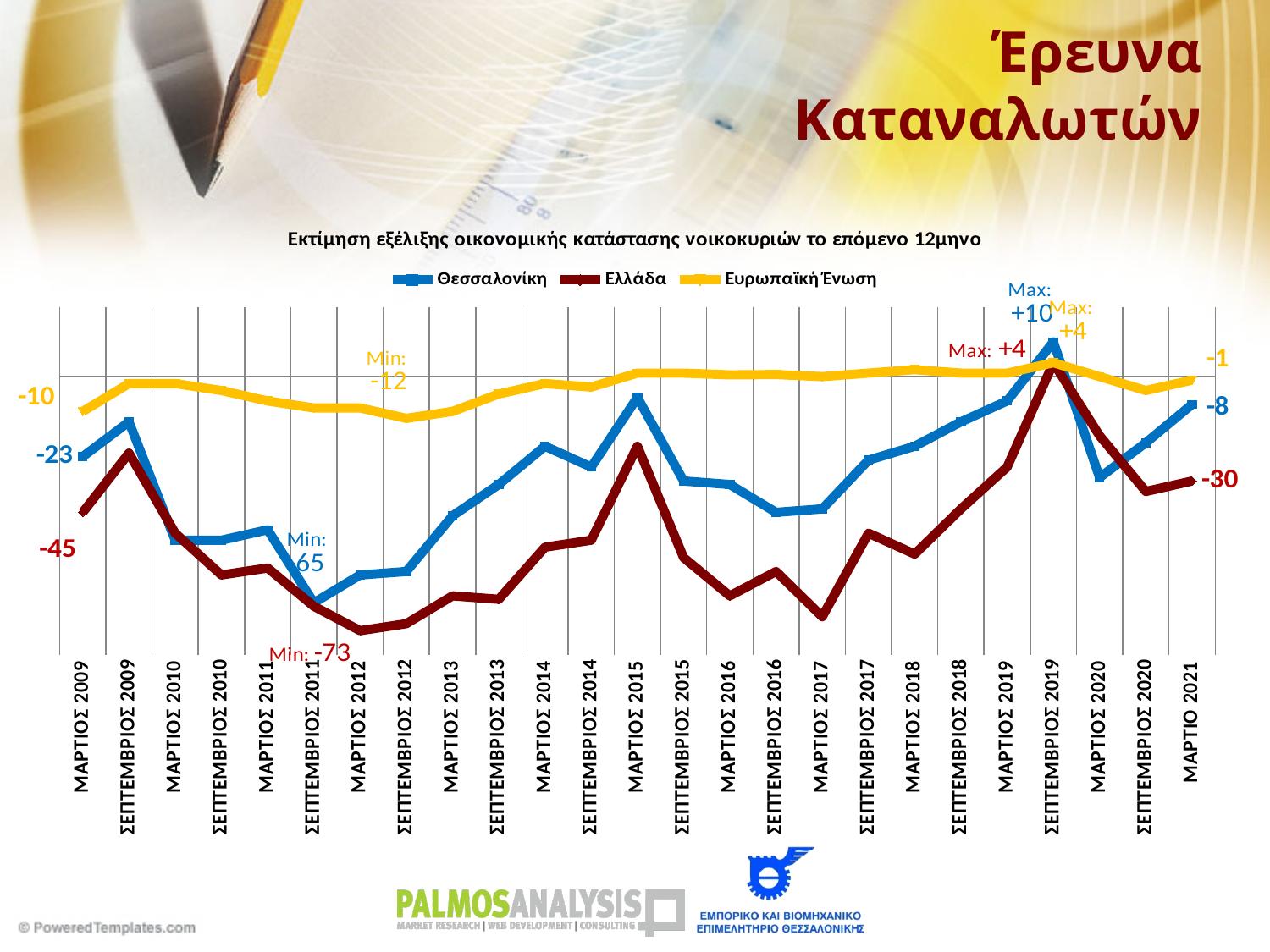
What is the value for Θεσσαλονίκη in ΜΑΡΤΙΟΣ 2009? -23 How many series does the legend list? 3 What is the minimum value reached by the Ελλάδα series? -73 What is the value for Ελλάδα in ΜΑΡΤΙΟ 2021? -30 What is the maximum value reached by the Θεσσαλονίκη series? +10 What is the value for Ελλάδα in ΜΑΡΤΙΟΣ 2009? -45 What is the value for Ευρωπαϊκή Ένωση in ΜΑΡΤΙΟ 2021? -1 In ΜΑΡΤΙΟ 2021, which series has the higher value, Θεσσαλονίκη or Ελλάδα? Θεσσαλονίκη How many time points are shown on the x axis? 25 What is the value for Θεσσαλονίκη in ΜΑΡΤΙΟ 2021? -8 What kind of chart is shown on the slide? Line chart By how much did the Ελλάδα value change between ΜΑΡΤΙΟΣ 2009 (-45) and ΜΑΡΤΙΟ 2021 (-30)? 15